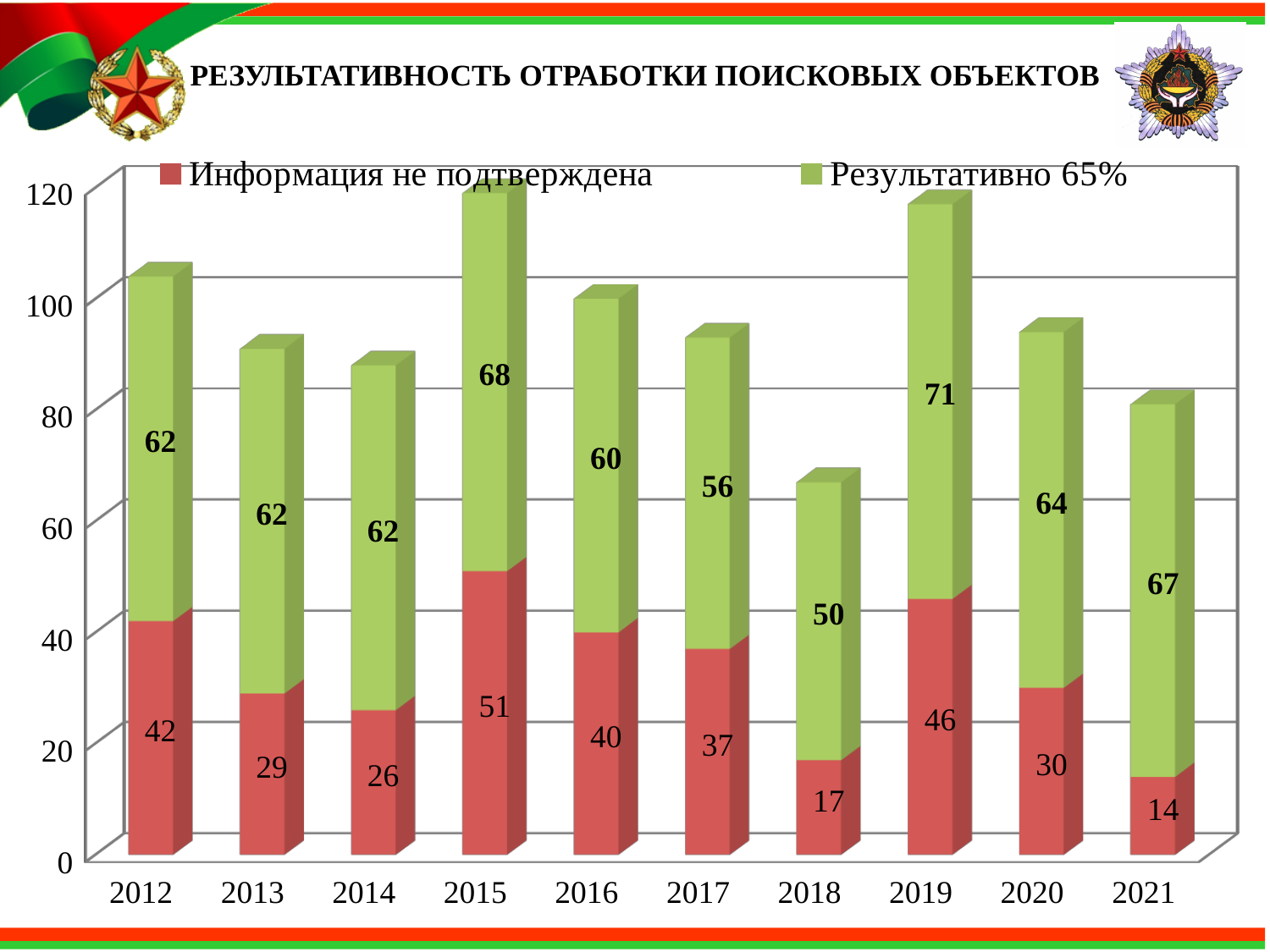
Which year has the lowest value for "Информация не подтверждена"? 2021 What is the difference between the "Результативно 65%" values for 2019 and 2018? 21 What is the total of the stacked bar for 2016? 100 Which is larger: the "Информация не подтверждена" value for 2012 or for 2016? 2012 How many series does the legend list? 2 What is the value of "Результативно 65%" for 2019? 71 What is the total of the stacked bar for 2018? 67 How many years are shown on the x axis? 10 Which year has the highest value for "Результативно 65%"? 2019 What is the value of "Информация не подтверждена" for 2015? 51 What colour represents the series "Информация не подтверждена"? Red What type of chart is shown on the slide? Stacked bar chart